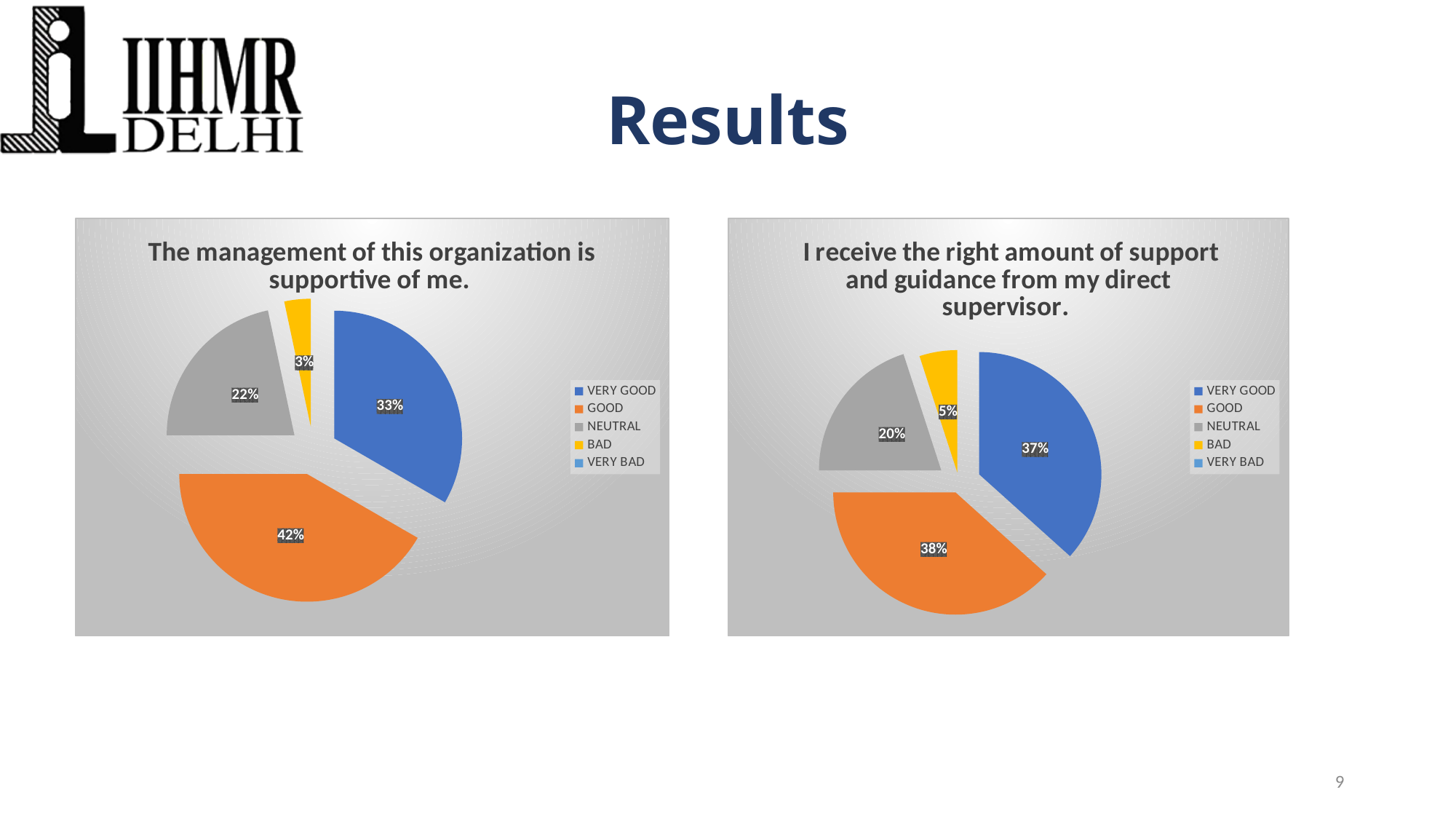
In the left chart, which visible response category has the smallest share? BAD What type of chart is used on the left side of the slide? Pie chart In the left chart, what is the difference between the GOOD and VERY GOOD shares? 9% In the left chart, which is larger: the NEUTRAL share or the VERY GOOD share? VERY GOOD In the right chart, what percentage of respondents answered NEUTRAL? 20% How many categories does the legend of the right chart list? 5 In the chart titled "I receive the right amount of support and guidance from my direct supervisor.", what percentage of respondents answered VERY GOOD? 37% In the right chart, what is the difference between the NEUTRAL and BAD shares? 15% In the left chart, which response category has the largest share? GOOD In the right chart, which visible response category has the smallest share? BAD In the chart titled "The management of this organization is supportive of me.", what percentage of respondents answered BAD? 3% In the chart titled "The management of this organization is supportive of me.", what percentage of respondents answered GOOD? 42%